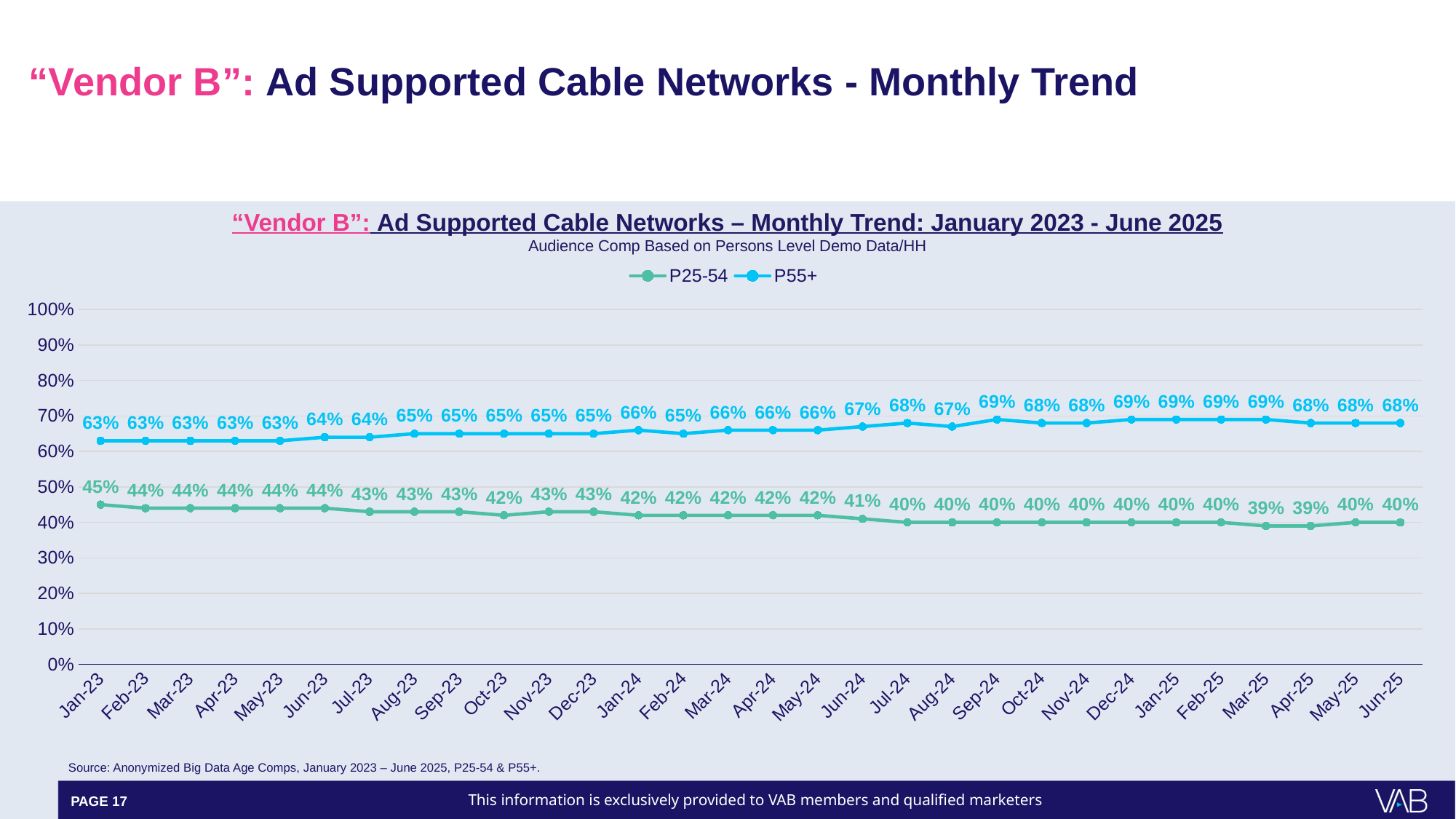
What is the difference between the P55+ and P25-54 values in Jun-25? 28% What is the P25-54 value for Jun-25? 40% What kind of chart is shown on the slide? Line chart What is the P55+ value for Sep-24? 69% How many series does the legend list? 2 Which series has the larger value in Mar-24, P25-54 or P55+? P55+ What is the difference between the P25-54 value in Jan-23 and in Jun-25? 5% What is the P55+ value for Jan-23? 63% What is the P25-54 value for Jan-23? 45% Does the P25-54 series generally rise or fall from Jan-23 to Jun-25? Fall In which month does the P25-54 series reach its highest value? Jan-23 How many monthly data points are plotted for each series? 30